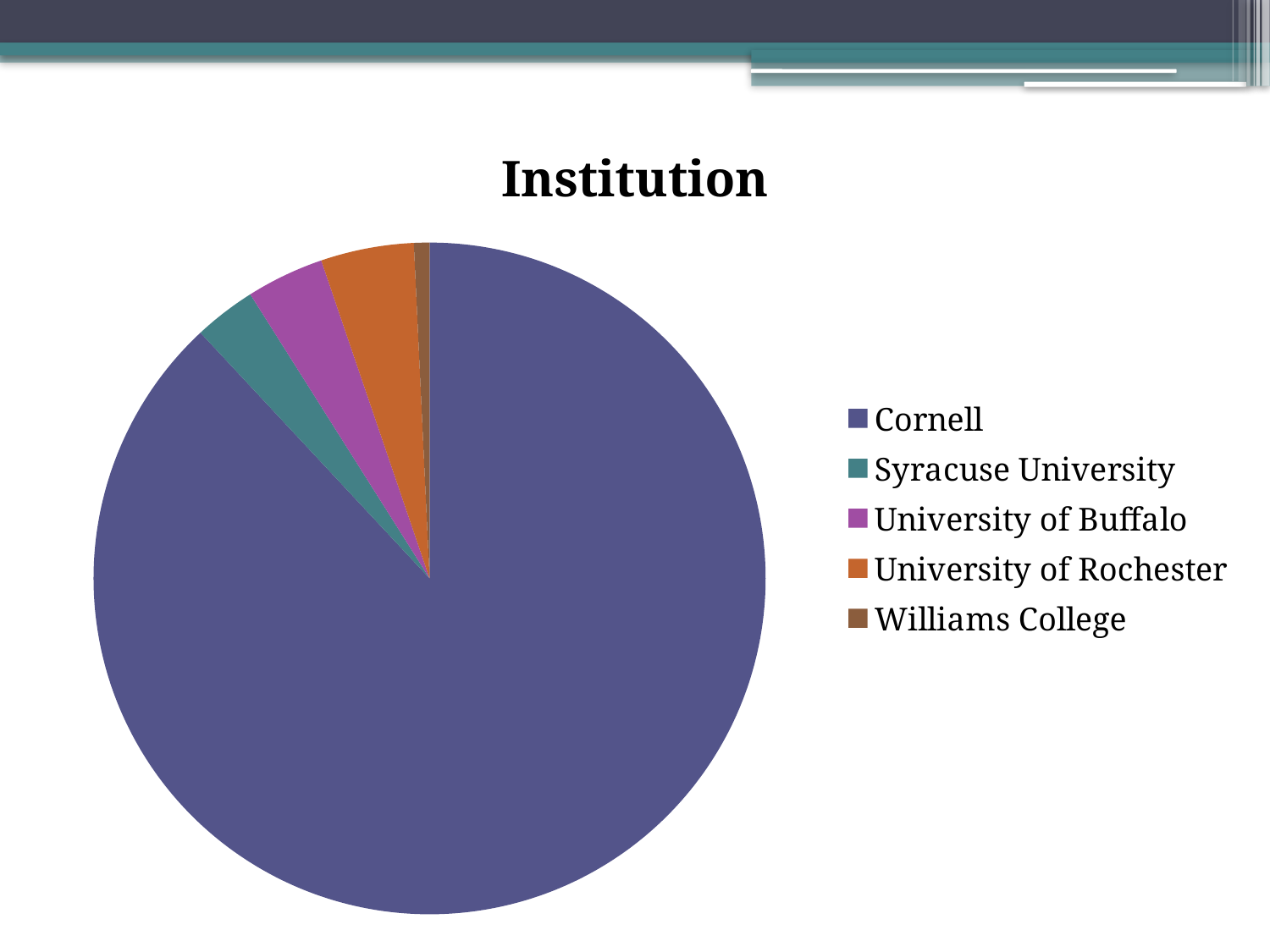
Which slice is larger, University of Rochester or Syracuse University? University of Rochester Which slice is larger, Cornell or University of Buffalo? Cornell What kind of chart is shown on the slide? pie chart Which institution has the smallest slice of the pie? Williams College Does Cornell account for more or less than half of the pie? more How many institutions (slices) does the pie chart show? 5 Which institution has the largest slice of the pie? Cornell What is the title of the chart? Institution Which institution is shown in orange in the pie chart? University of Rochester